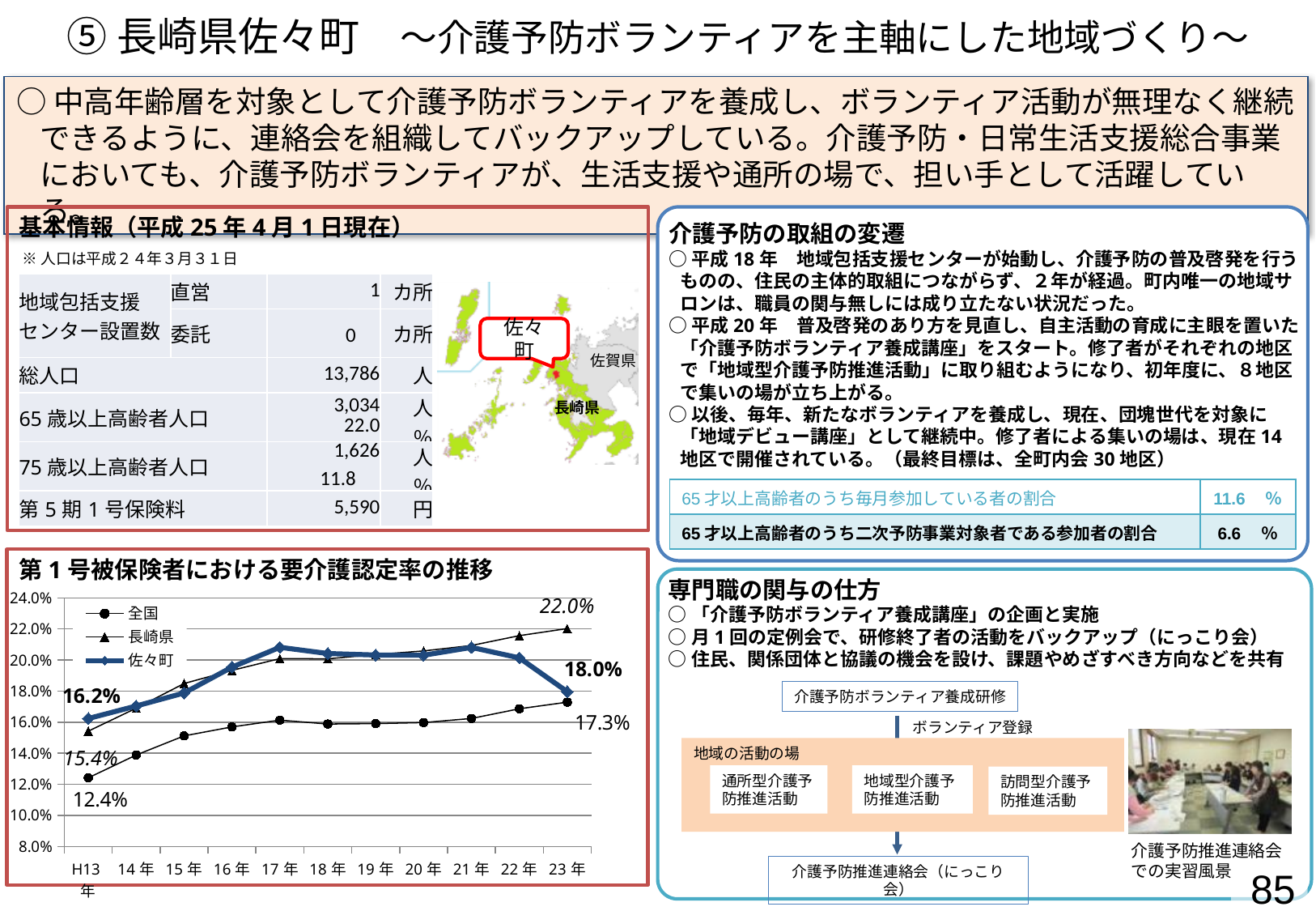
In the 要介護認定率 chart, what is the value for 全国 at 23年? 17.3% In the 要介護認定率 chart, what is the value for 長崎県 at 23年? 22.0% How many years are shown on the x axis of the 要介護認定率 chart? 11 In the 要介護認定率 chart, is the value for 佐々町 at 17年 greater or less than 20.0%? greater What kind of chart is 「第1号被保険者における要介護認定率の推移」? line chart In the 要介護認定率 chart, what is the difference between 長崎県 (22.0%) and 全国 (17.3%) at 23年? 4.7% In the 要介護認定率 chart, what is the value for 全国 at H13年? 12.4% In the 要介護認定率 chart, by how much did the 佐々町 value change from H13年 (16.2%) to 23年 (18.0%)? 1.8% In the 要介護認定率 chart, which series has the highest value at H13年? 佐々町 How many series does the legend of the 要介護認定率 chart list? 3 In the 要介護認定率 chart, what is the value for 佐々町 at 23年? 18.0% In the 要介護認定率 chart, what is the value for 佐々町 at H13年? 16.2%